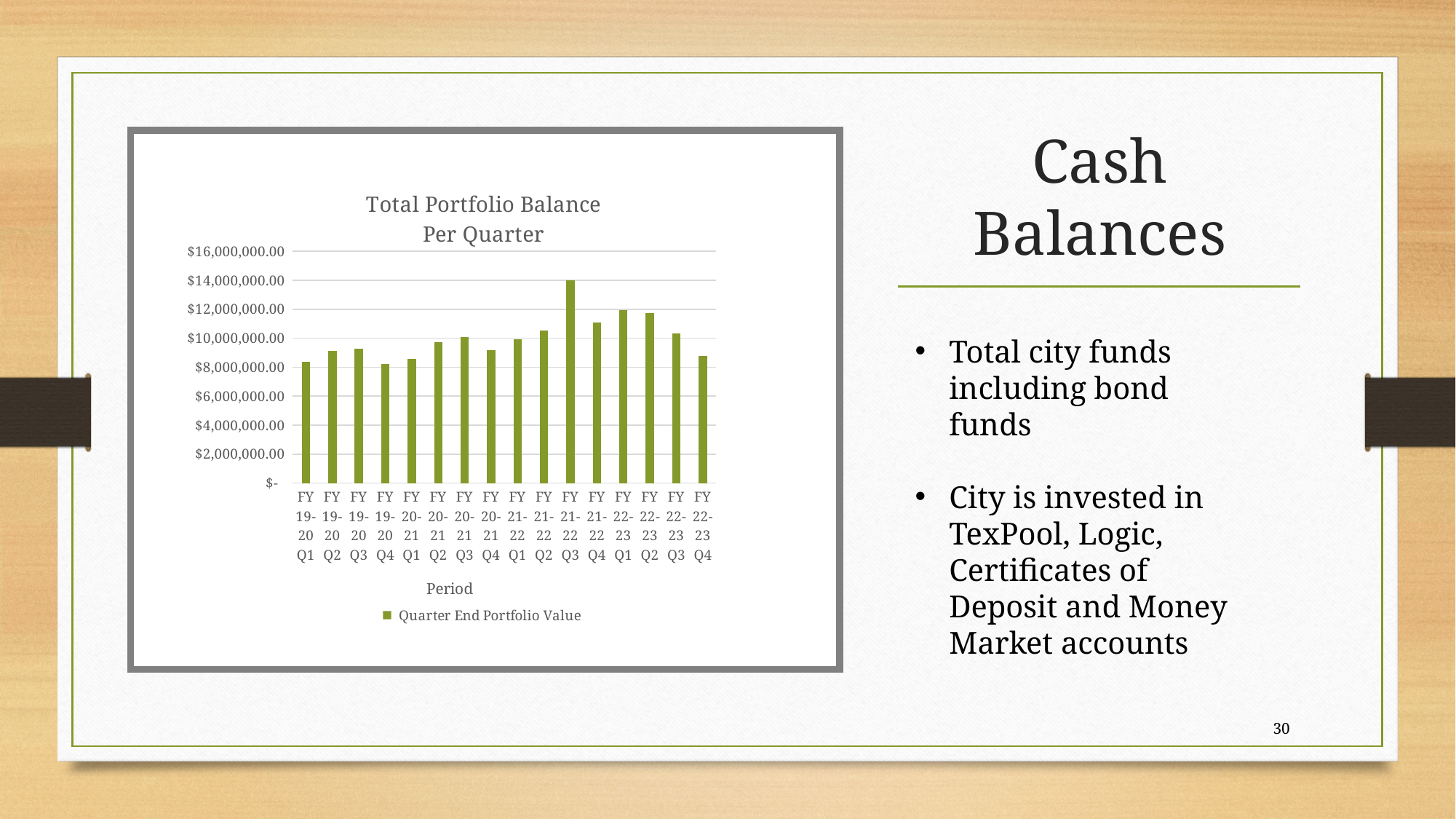
Is the value for FY 22-23 Q4 greater or less than $10,000,000.00? less Which period has the highest Quarter End Portfolio Value? FY 21-22 Q3 Which is larger, the value for FY 21-22 Q3 or the value for FY 22-23 Q4? FY 21-22 Q3 Is the value for FY 21-22 Q3 greater or less than $12,000,000.00? greater What is the title of the chart? Total Portfolio Balance Per Quarter Is the value for FY 19-20 Q1 greater or less than $10,000,000.00? less How many series does the chart legend list? 1 What kind of chart is shown on the slide? Bar chart Which is larger, the value for FY 22-23 Q1 or the value for FY 19-20 Q4? FY 22-23 Q1 How many quarters (bars) are plotted in the chart? 16 What is the name of the series shown in the legend? Quarter End Portfolio Value